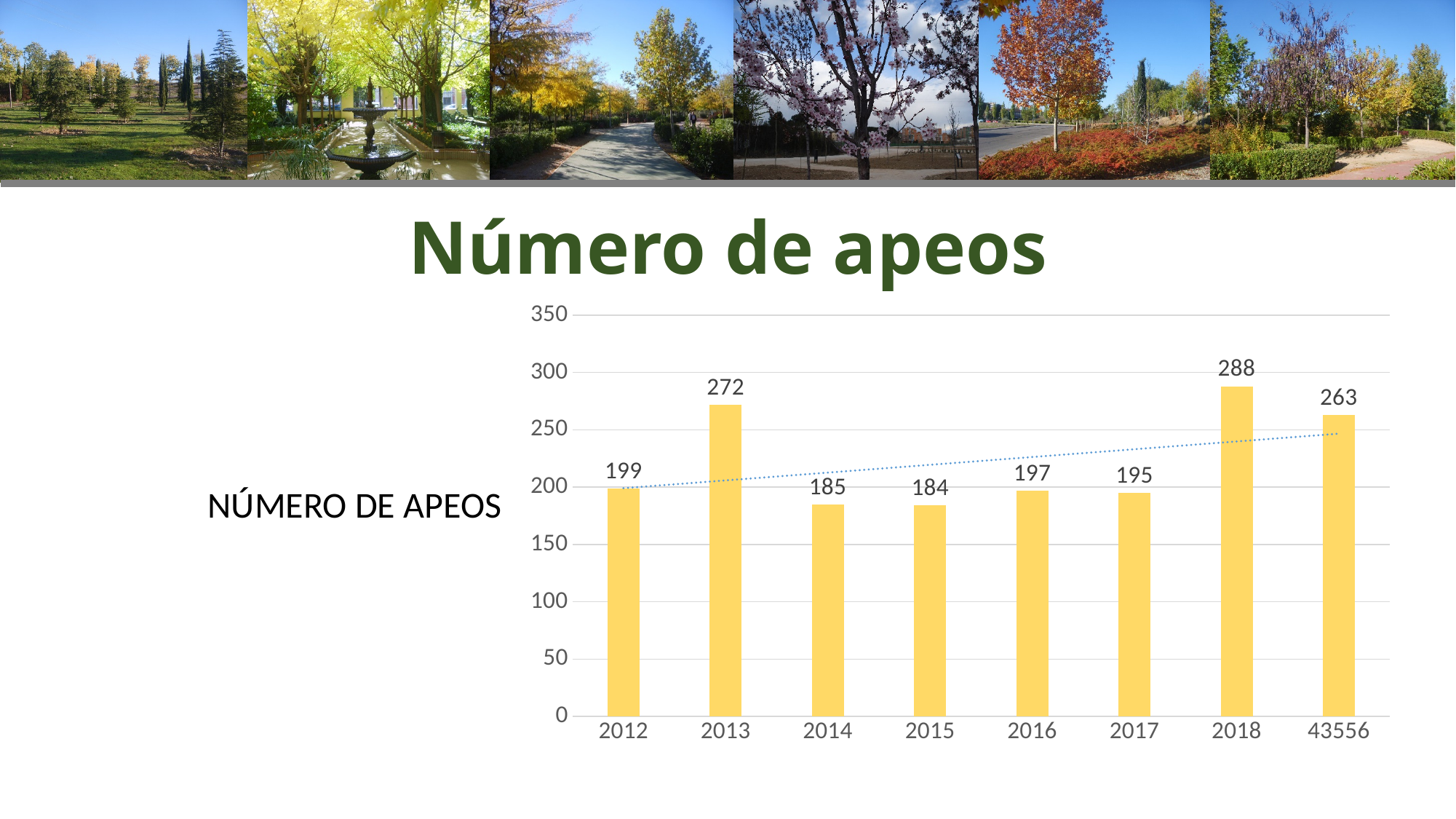
Does the dotted trend line rise or fall from left to right? rise What is the value for 2016? 197 Which is larger, the value for 2013 or the value for 2014? 2013 What is the difference between the values for 2018 and 2012? 89 What is the title of the slide? Número de apeos How many categories are shown on the x axis? 8 Which category has the lowest value? 2015 What is the value for 2013? 272 Which category has the highest value? 2018 Is the value for 2017 greater or less than 250? less What kind of chart is shown? bar chart What is the value for the category labelled 43556? 263